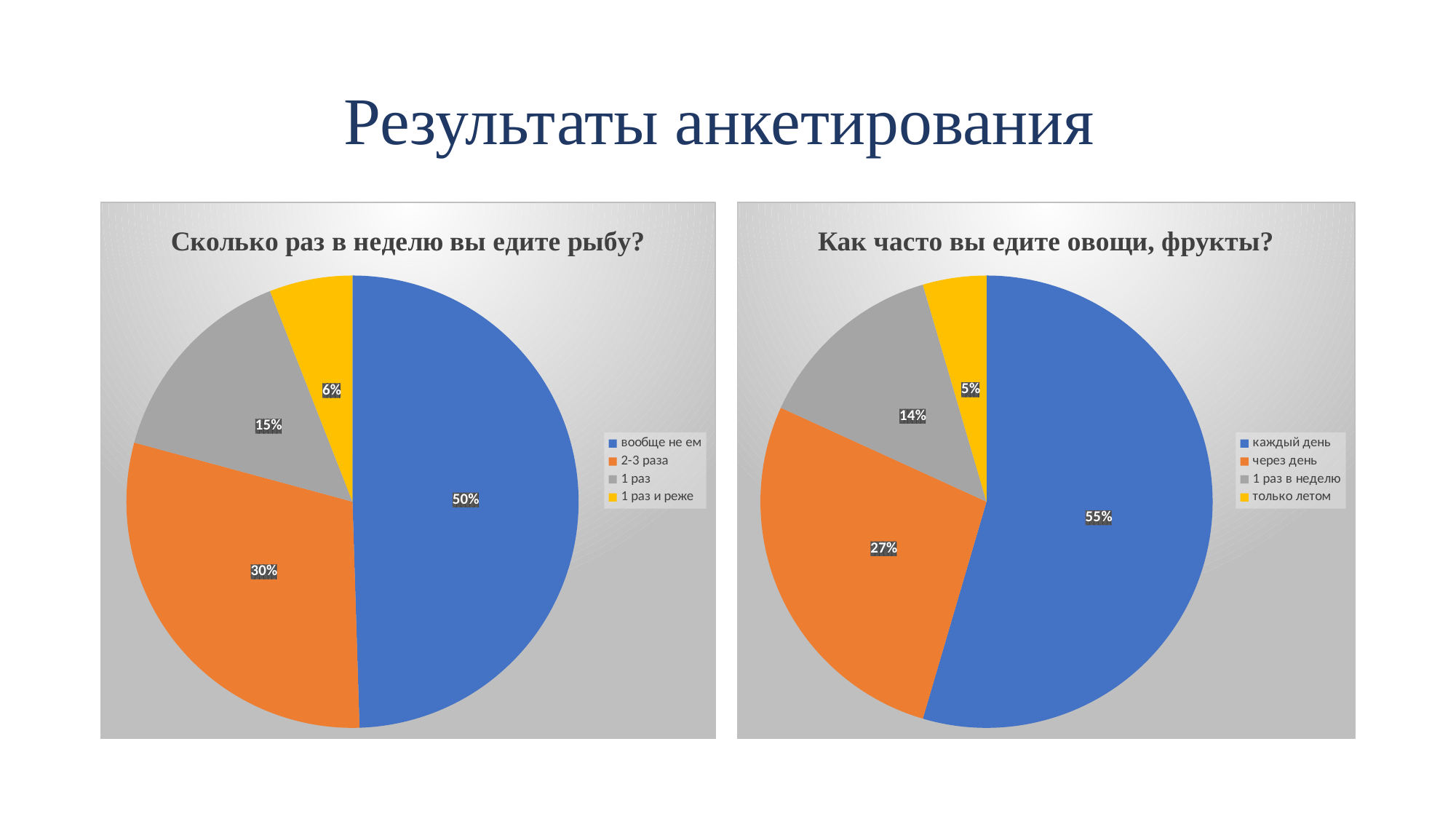
In the chart titled "Сколько раз в неделю вы едите рыбу?", which category has the smallest slice? 1 раз и реже In the chart titled "Как часто вы едите овощи, фрукты?", what colour is the "1 раз в неделю" slice? Grey In the chart titled "Как часто вы едите овощи, фрукты?", what is the difference between the "каждый день" and "через день" shares? 28% What type of chart is the chart titled "Как часто вы едите овощи, фрукты?"? Pie chart In the chart titled "Сколько раз в неделю вы едите рыбу?", what share is labelled for "вообще не ем"? 50% In the chart titled "Сколько раз в неделю вы едите рыбу?", what share is labelled for "2-3 раза"? 30% In the chart titled "Как часто вы едите овощи, фрукты?", what share is labelled for "только летом"? 5% In the chart titled "Как часто вы едите овощи, фрукты?", which is larger: "через день" or "1 раз в неделю"? через день In the chart titled "Сколько раз в неделю вы едите рыбу?", what is the difference between the "2-3 раза" and "1 раз" shares? 15% In the chart titled "Сколько раз в неделю вы едите рыбу?", how many categories does the legend list? 4 In the chart titled "Как часто вы едите овощи, фрукты?", what share is labelled for "каждый день"? 55% In the chart titled "Как часто вы едите овощи, фрукты?", which category has the largest slice? каждый день